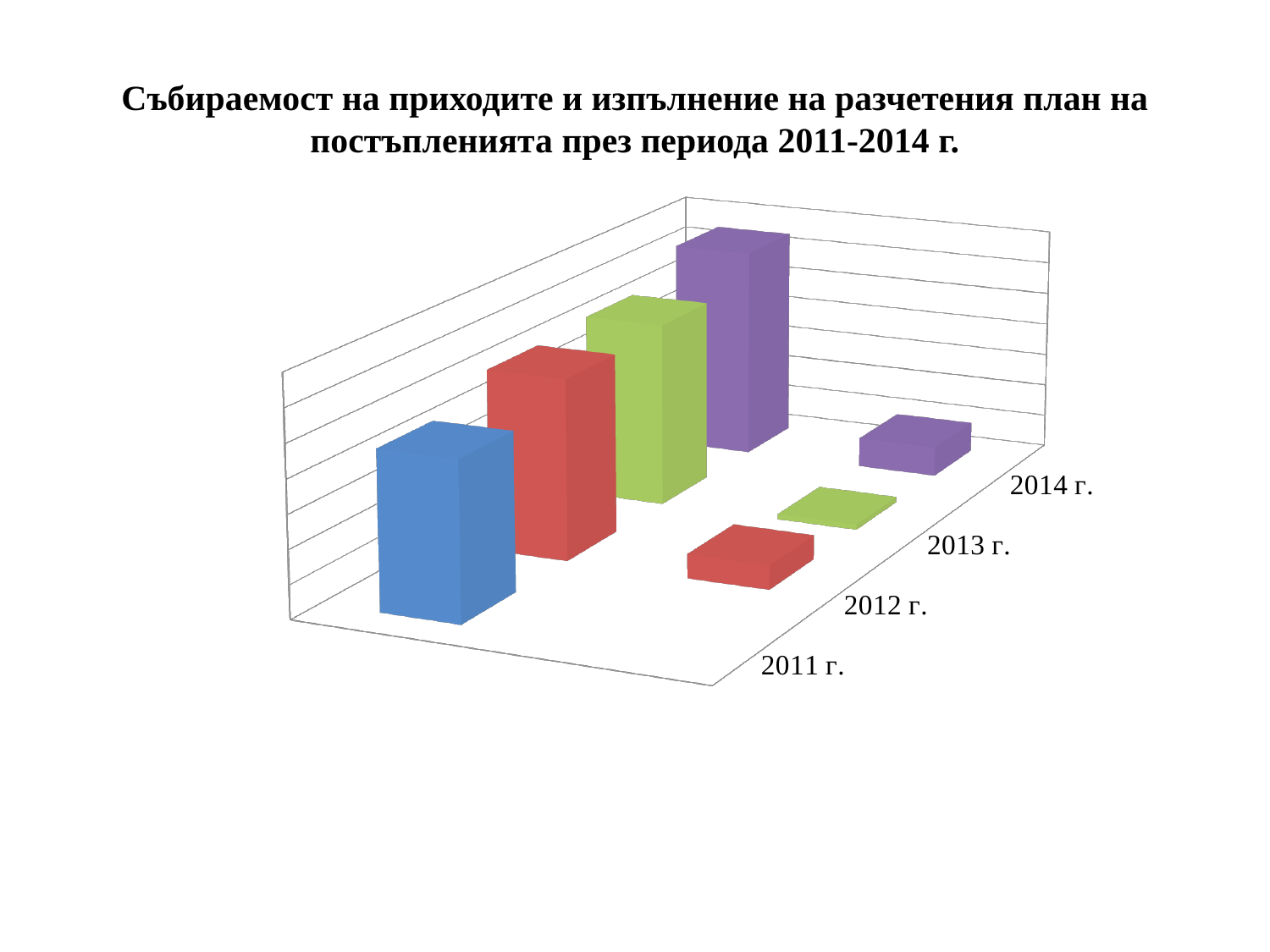
What kind of chart is shown on the slide? bar chart Which year has the tallest bar in the front row of bars? 2014 г. What period does the chart title say the data covers? 2011-2014 г. Which year has the shortest bar in the front row of bars? 2011 г. In the front row of bars, is the bar for 2013 г. taller or shorter than the bar for 2012 г.? taller What colour is the bar for 2011 г.? blue In the front row of bars, is the bar for 2014 г. taller or shorter than the bar for 2011 г.? taller Do the front-row bars rise or fall from 2011 г. to 2014 г.? rise How many bars are plotted for each year? 2 for 2012 г., 2013 г. and 2014 г.; only 1 for 2011 г. How many years (categories) are shown on the chart's axis? 4